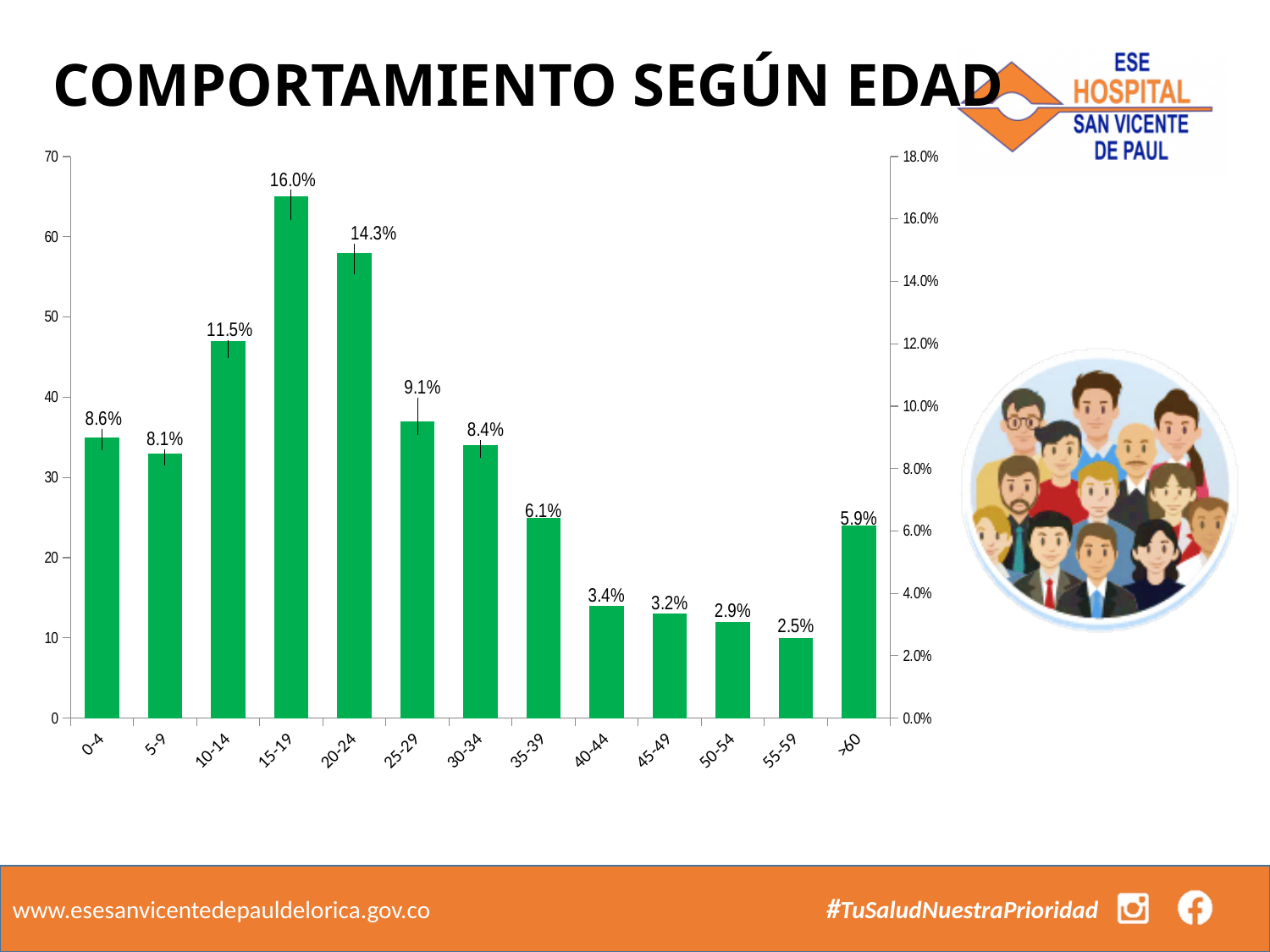
On the left axis, is the value for the 15-19 bar greater or less than 60? greater What is the percentage shown for the 15-19 age group? 16.0% Which age group has a larger percentage, 10-14 or 25-29? 10-14 What is the difference between the percentages for the 15-19 and 20-24 age groups? 1.7% Which age group has the lowest percentage? 55-59 Which age group has the highest percentage? 15-19 What is the title of the slide? COMPORTAMIENTO SEGÚN EDAD How many age groups are shown on the x axis? 13 What is the percentage shown for the 0-4 age group? 8.6% What kind of chart is shown on the slide? Bar chart Do the percentages rise or fall from the 15-19 age group to the 55-59 age group? Fall What is the percentage shown for the >60 age group? 5.9%